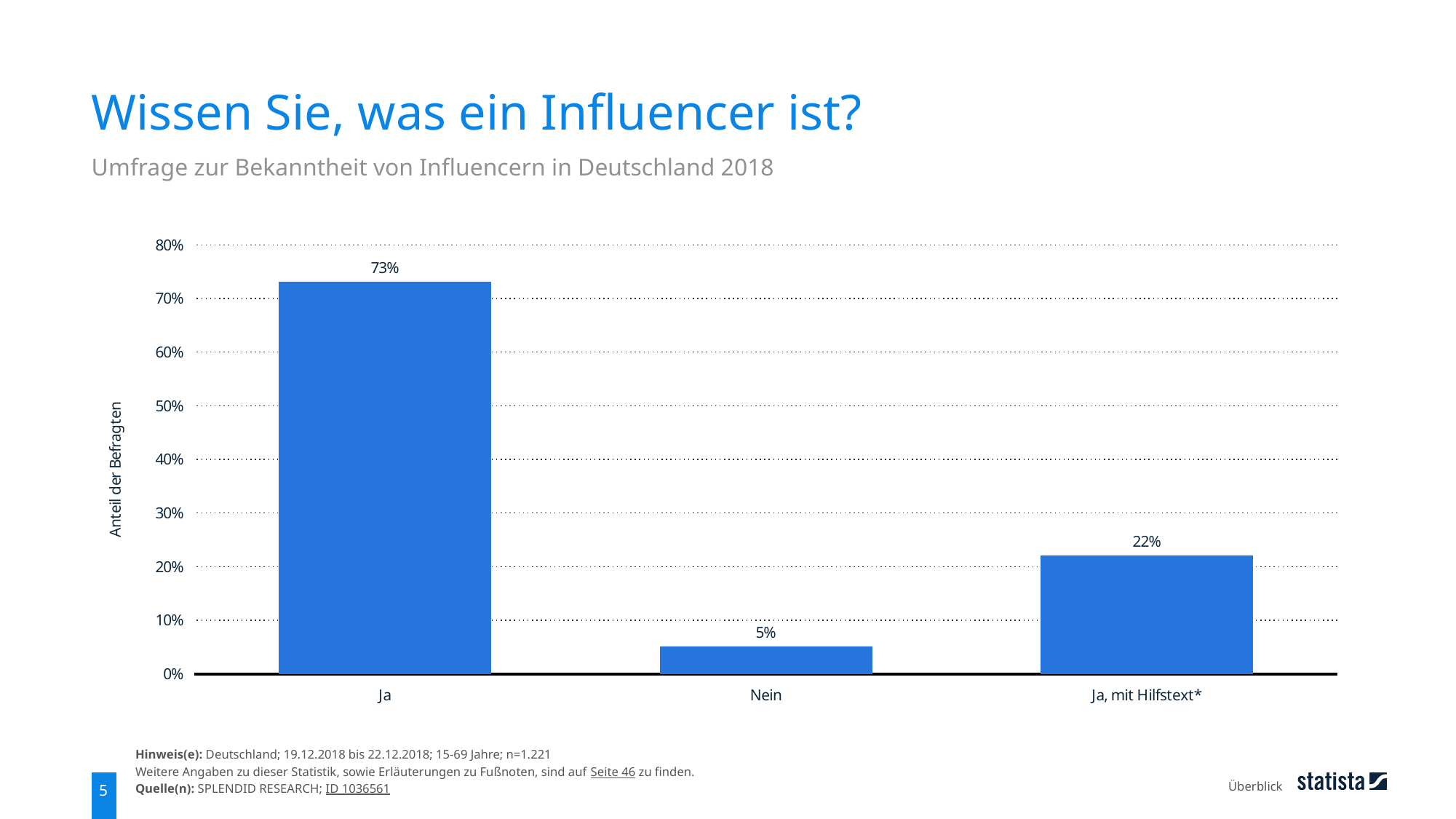
What is the value for "Nein"? 5% What is the value for "Ja, mit Hilfstext*"? 22% Is the value for "Ja" greater or less than 70%? greater Which category has the highest value? Ja Which category has the lowest value? Nein Which is larger, the value for "Nein" or the value for "Ja, mit Hilfstext*"? Ja, mit Hilfstext* What is the difference between the values for "Ja, mit Hilfstext*" and "Nein"? 17% What is the label of the y axis? Anteil der Befragten What is the difference between the values for "Ja" and "Ja, mit Hilfstext*"? 51% How many categories are shown on the x axis? 3 What kind of chart is shown on the slide? bar chart What is the value for "Ja"? 73%